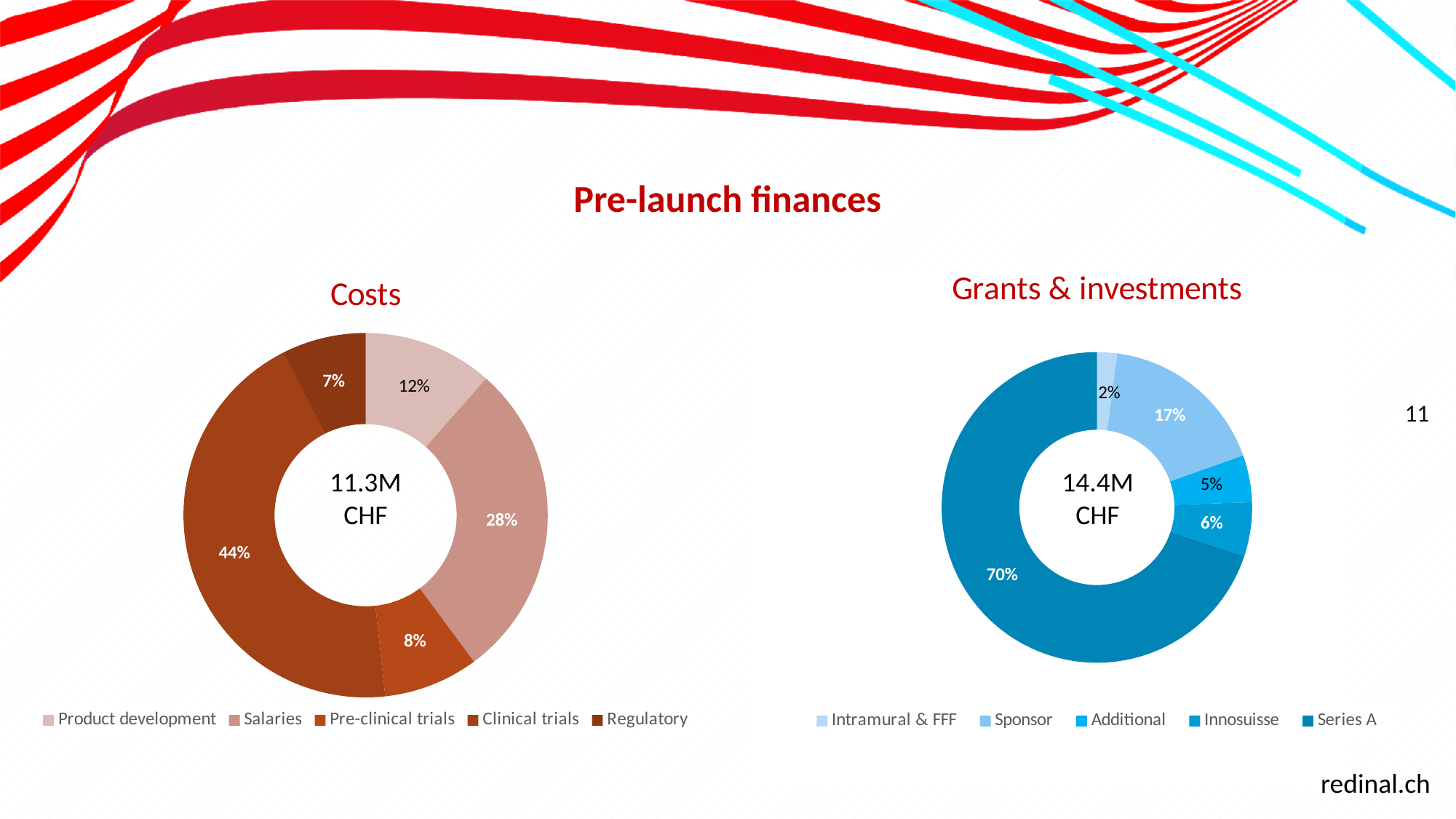
In the Grants & investments chart, what percentage is shown for Sponsor? 17% How many categories does the legend of the Grants & investments chart list? 5 In the Grants & investments chart, what share is Series A? 70% In the Costs chart, what share of costs is Clinical trials? 44% In the Costs chart, which category has the largest share? Clinical trials In the Costs chart, which category has the smallest share? Regulatory What type of chart is the Costs chart? Donut (pie) chart In the Costs chart, what percentage is shown for Salaries? 28% In the Grants & investments chart, which is larger, Innosuisse or Additional? Innosuisse In the Grants & investments chart, which source has the smallest share? Intramural & FFF In the Costs chart, what total amount is shown in the centre of the donut? 11.3M CHF In the Costs chart, what is the difference in percentage points between Salaries and Product development? 16